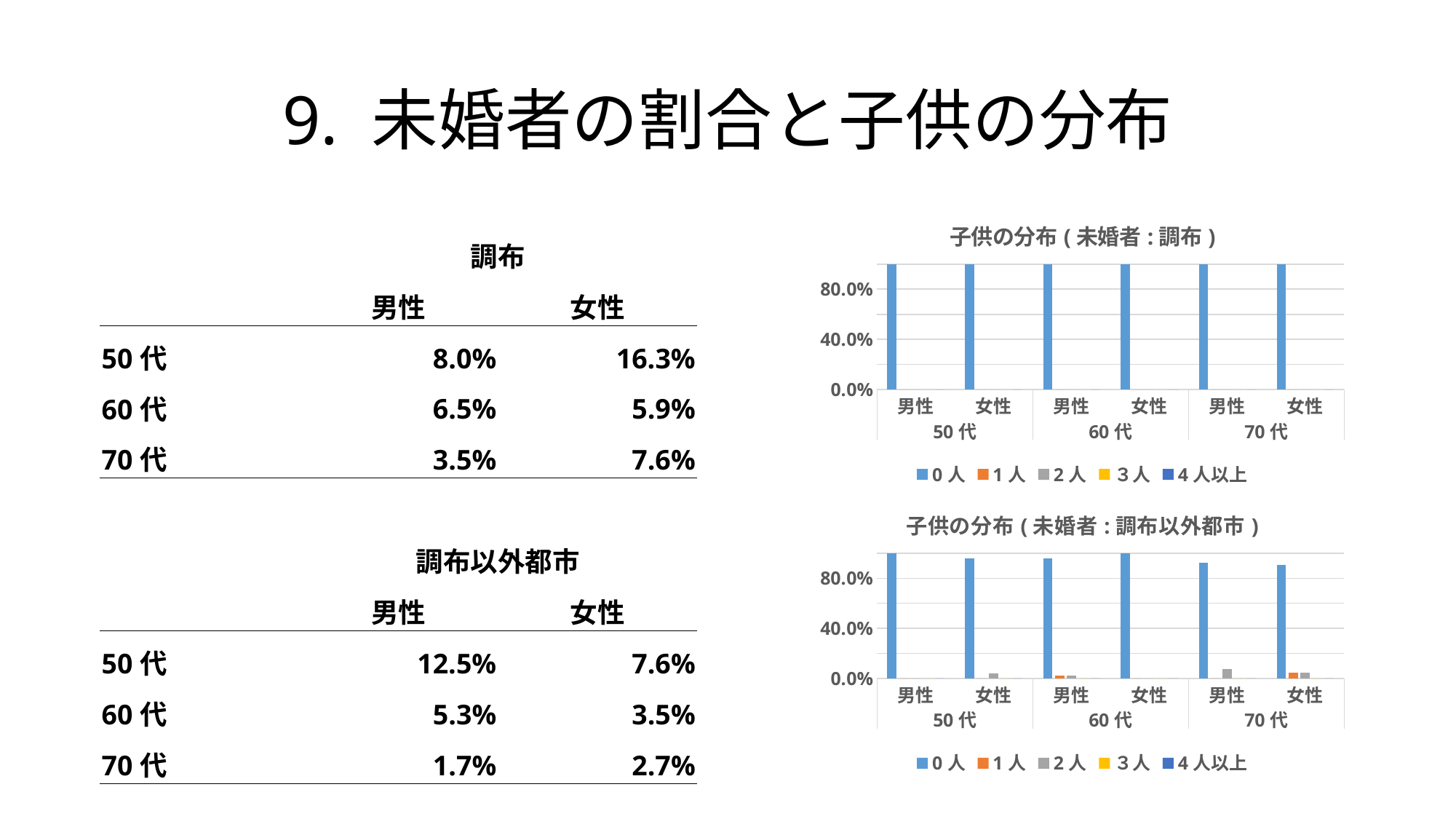
How many series does the legend of the chart titled 子供の分布（未婚者：調布以外都市） list? 5 In the chart titled 子供の分布（未婚者：調布以外都市）, which is larger for 男性 in 60代: 0人 or 1人? 0人 In the chart titled 子供の分布（未婚者：調布）, is the value of 0人 for 男性 in 50代 greater or less than 80.0%? greater What is the title of the lower chart on the right side of the slide? 子供の分布（未婚者：調布以外都市） In the chart titled 子供の分布（未婚者：調布以外都市）, is the value of 0人 for 女性 in 70代 greater or less than 80.0%? greater What kind of chart is the chart titled 子供の分布（未婚者：調布）? bar chart In the chart titled 子供の分布（未婚者：調布以外都市）, which is larger for 女性 in 70代: 0人 or 2人? 0人 In the chart titled 子供の分布（未婚者：調布）, which legend entry is shown in blue? 0人 In the chart titled 子供の分布（未婚者：調布以外都市）, which series has the highest value for 女性 in 50代? 0人 In the chart titled 子供の分布（未婚者：調布以外都市）, is the value of 2人 for 男性 in 70代 greater or less than 40.0%? less In the chart titled 子供の分布（未婚者：調布）, how many gender-by-age-group categories are shown on the x axis? 6